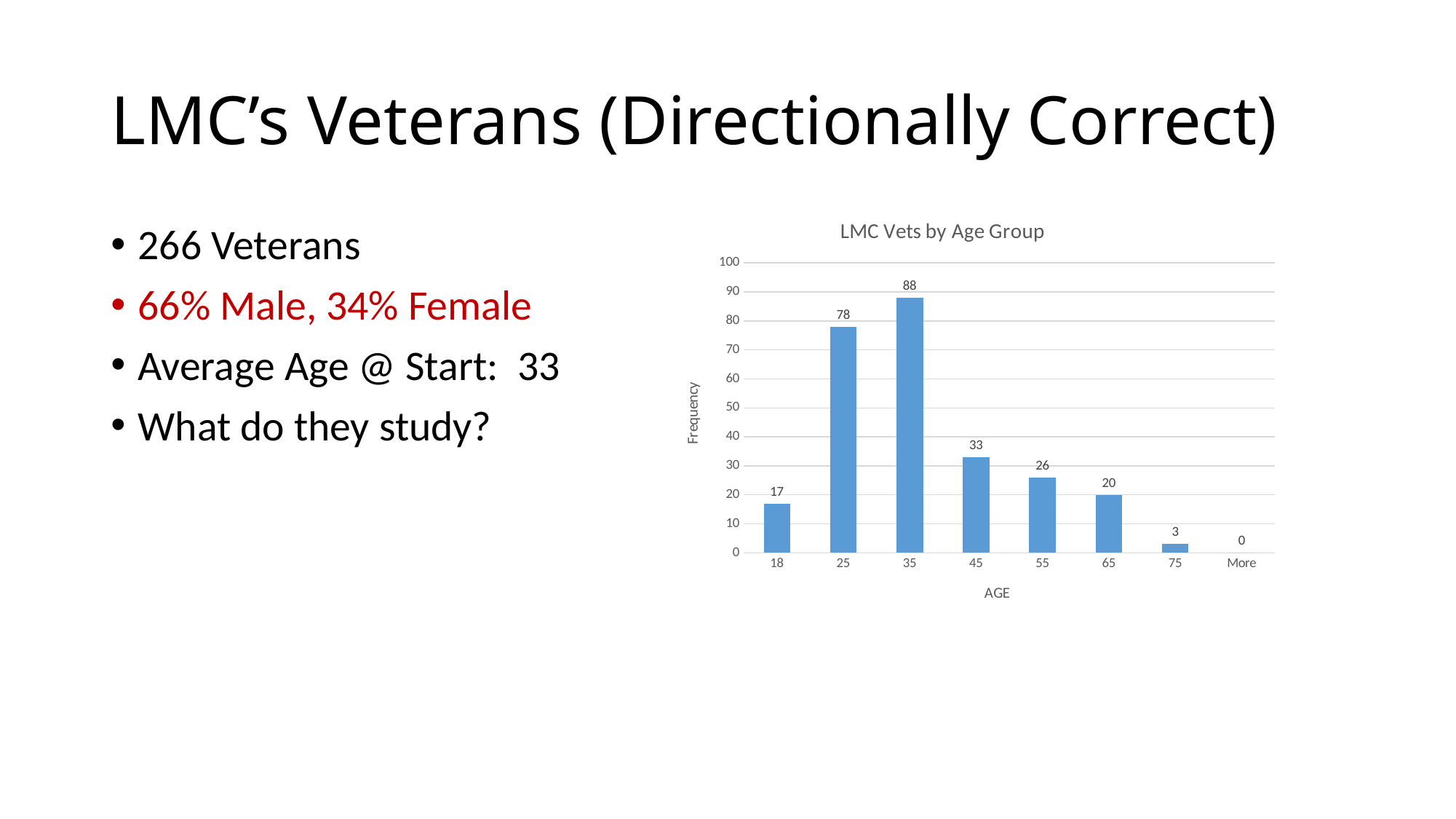
Is the frequency for the 45 age group greater or less than 30? greater What is the difference in frequency between the 45 and 55 age groups? 7 What is the frequency for the 25 age group? 78 What is the difference in frequency between the 35 and 25 age groups? 10 What is the frequency for the 35 age group? 88 How many age group categories are shown on the x axis? 8 Which age group has the highest frequency? 35 What is the frequency for the 65 age group? 20 Which age group has a higher frequency, 18 or 65? 65 What is the title of the chart? LMC Vets by Age Group What kind of chart is shown on the slide? Bar chart Which age group has the lowest frequency? More